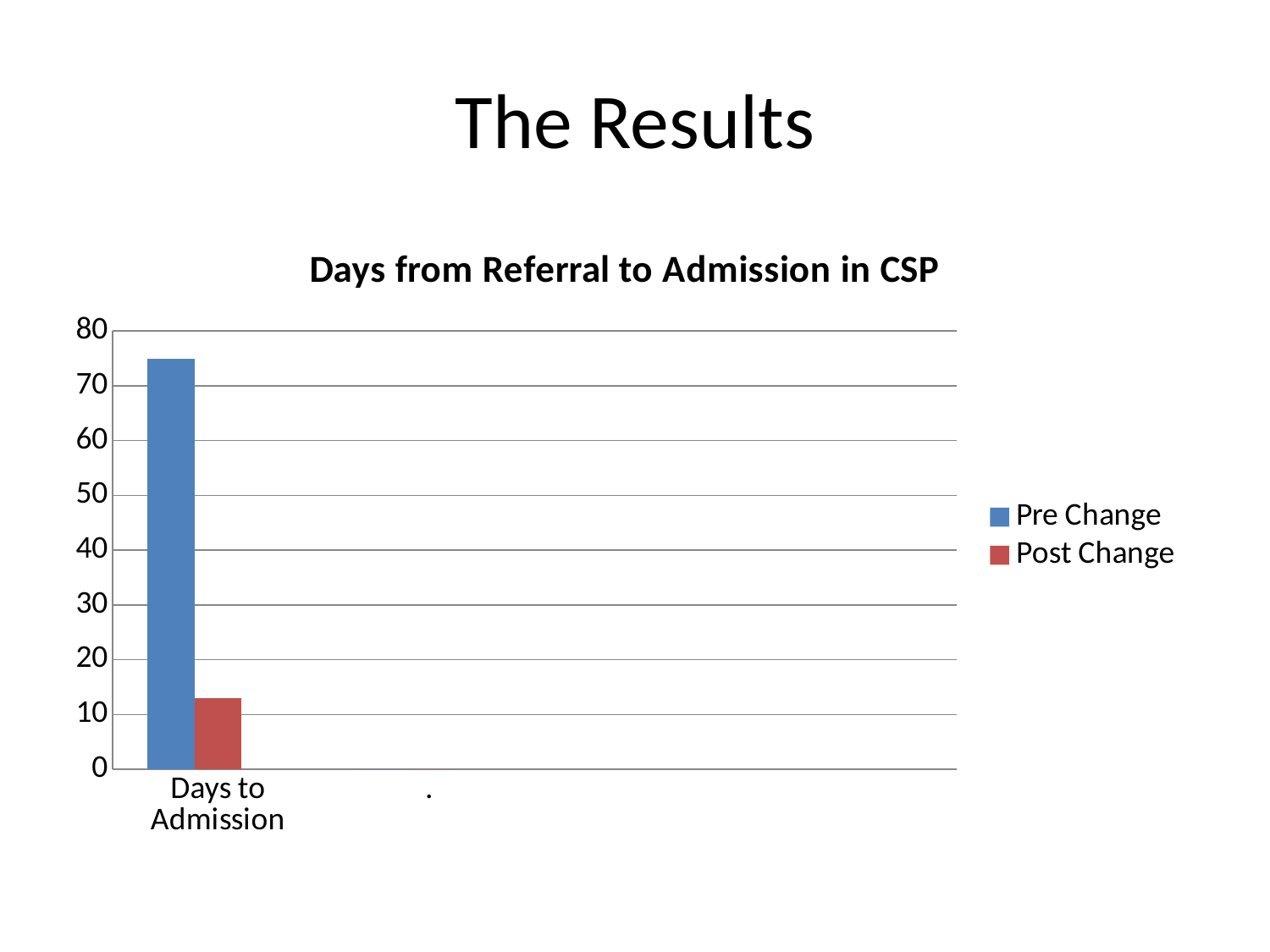
Which series has the lowest value for Days to Admission? Post Change Is the Post Change value for Days to Admission greater or less than 20? less Which series is larger for Days to Admission, Pre Change or Post Change? Pre Change Is the Post Change value for Days to Admission greater or less than 10? greater What is the title of the chart? Days from Referral to Admission in CSP What colour is the Post Change series in the chart? red Is the Pre Change value for Days to Admission greater or less than 70? greater How many series does the legend list? 2 What type of chart is shown on the slide? bar chart What is the highest value shown on the vertical axis? 80 Which series has the highest value for Days to Admission? Pre Change